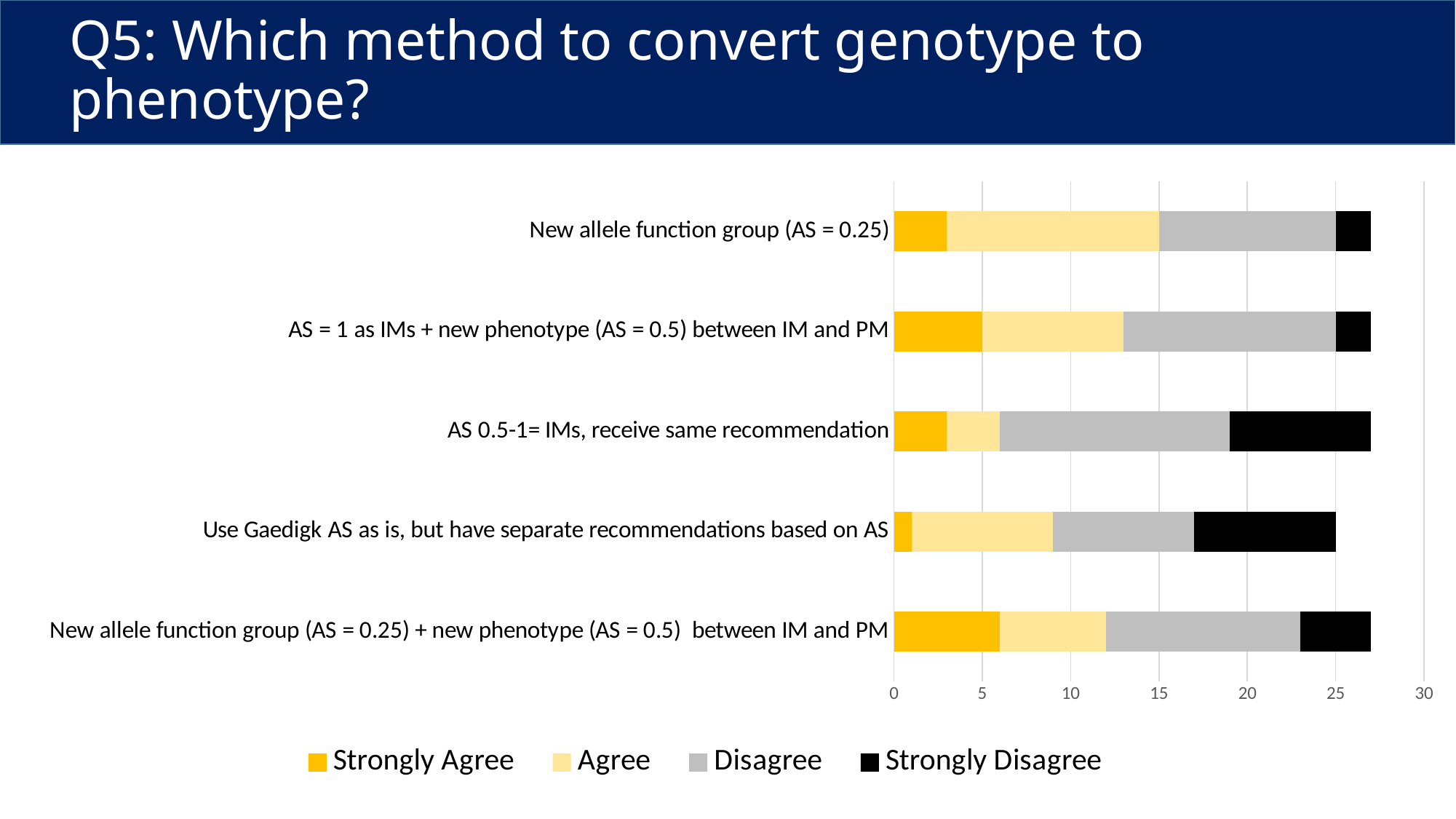
Which has the larger Strongly Agree value: 'New allele function group (AS = 0.25) + new phenotype (AS = 0.5) between IM and PM' or 'Use Gaedigk AS as is, but have separate recommendations based on AS'? New allele function group (AS = 0.25) + new phenotype (AS = 0.5) between IM and PM Is the Strongly Agree value for 'New allele function group (AS = 0.25) + new phenotype (AS = 0.5) between IM and PM' greater or less than 5? greater Which category has the lowest Strongly Agree value? Use Gaedigk AS as is, but have separate recommendations based on AS What is the title of the slide containing the chart? Q5: Which method to convert genotype to phenotype? What kind of chart is shown on the slide? Stacked bar chart Is the total length of the bar for 'New allele function group (AS = 0.25)' greater or less than 25? greater Which category has the highest Agree value? New allele function group (AS = 0.25) Which category has the lowest Agree value? AS 0.5-1= IMs, receive same recommendation Which colour represents the Strongly Disagree series in the legend? Black How many series does the legend list? 4 How many methods (categories) are plotted in the chart? 5 Is the Strongly Agree value for 'Use Gaedigk AS as is, but have separate recommendations based on AS' greater or less than 5? less